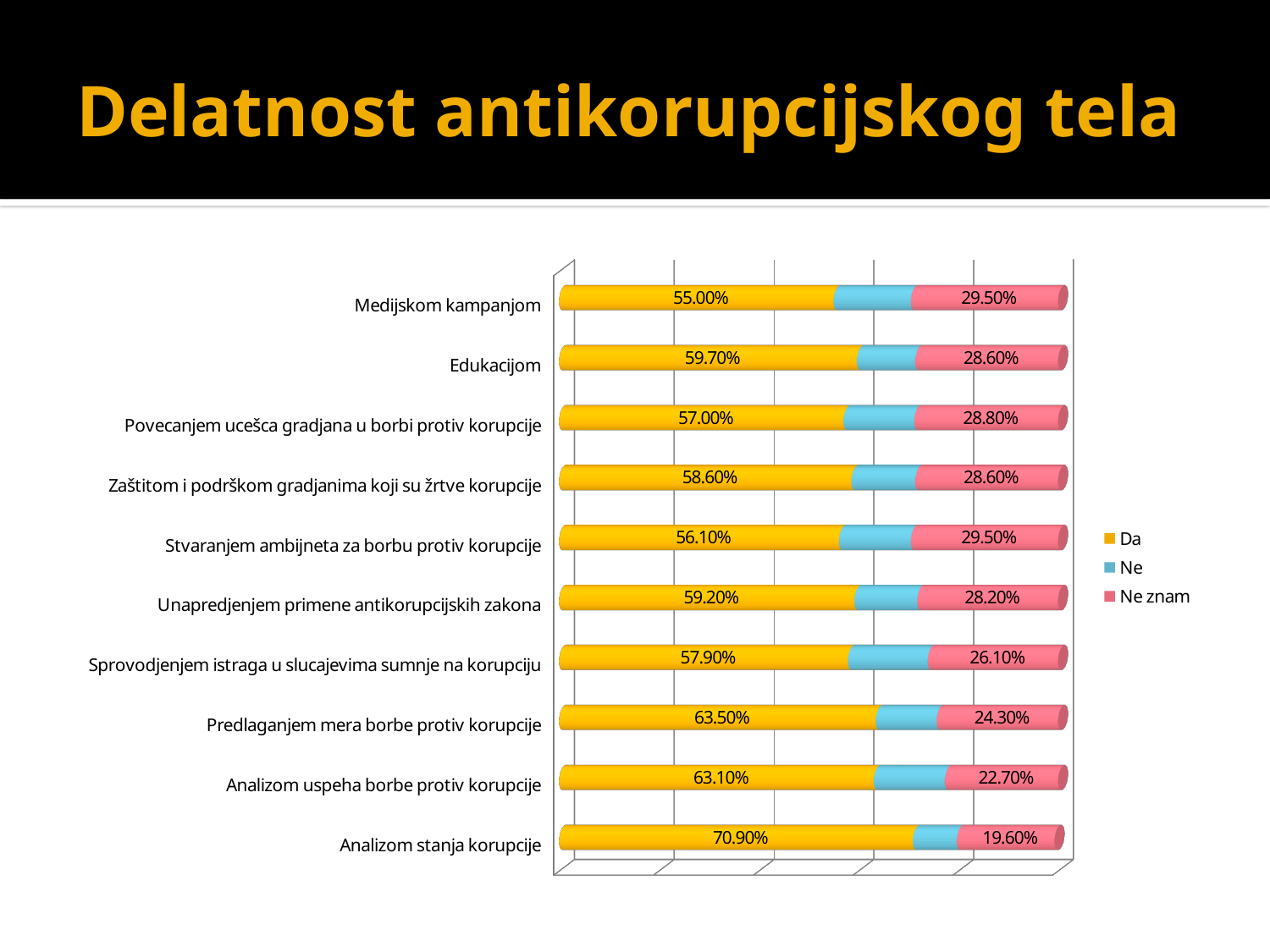
What is the difference between the 'Da' values for 'Analizom stanja korupcije' and 'Medijskom kampanjom'? 15.90% What kind of chart is shown on the slide? Stacked bar chart What is the 'Da' value for 'Edukacijom'? 59.70% Which category has the lowest 'Da' value? Medijskom kampanjom How many categories are shown in the chart? 10 What is the 'Da' value for 'Analizom stanja korupcije'? 70.90% What is the 'Ne znam' value for 'Predlaganjem mera borbe protiv korupcije'? 24.30% Which has a larger 'Da' value: 'Edukacijom' or 'Povecanjem ucešca gradjana u borbi protiv korupcije'? Edukacijom Which category has the highest 'Da' value? Analizom stanja korupcije How many series does the legend list? 3 What is the 'Ne znam' value for 'Medijskom kampanjom'? 29.50% Which category has the lowest 'Ne znam' value? Analizom stanja korupcije